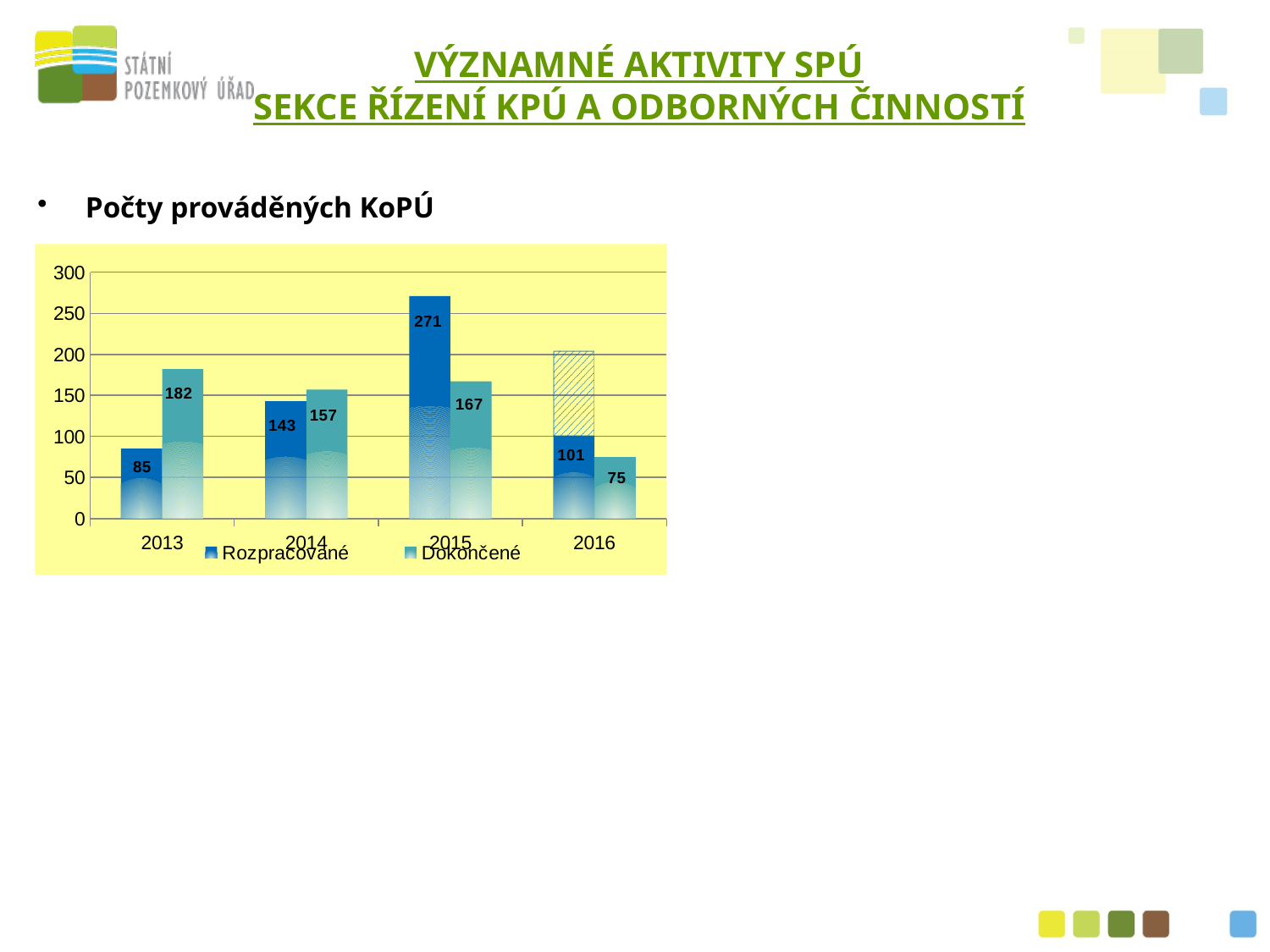
In which year is the Dokončené value lowest? 2016 How many series does the legend list? 2 What is the value for Rozpracované in 2014? 143 What kind of chart is shown on the slide? bar chart How many years are shown on the x axis? 4 What is the value for Rozpracované in 2015? 271 What is the difference between the Rozpracované and Dokončené values in 2013? 97 Is the Rozpracované value for 2015 greater or less than 250? greater Which is larger in 2014, Rozpracované or Dokončené? Dokončené In which year is the Rozpracované value highest? 2015 What is the value for Dokončené in 2013? 182 What is the value for Dokončené in 2016? 75